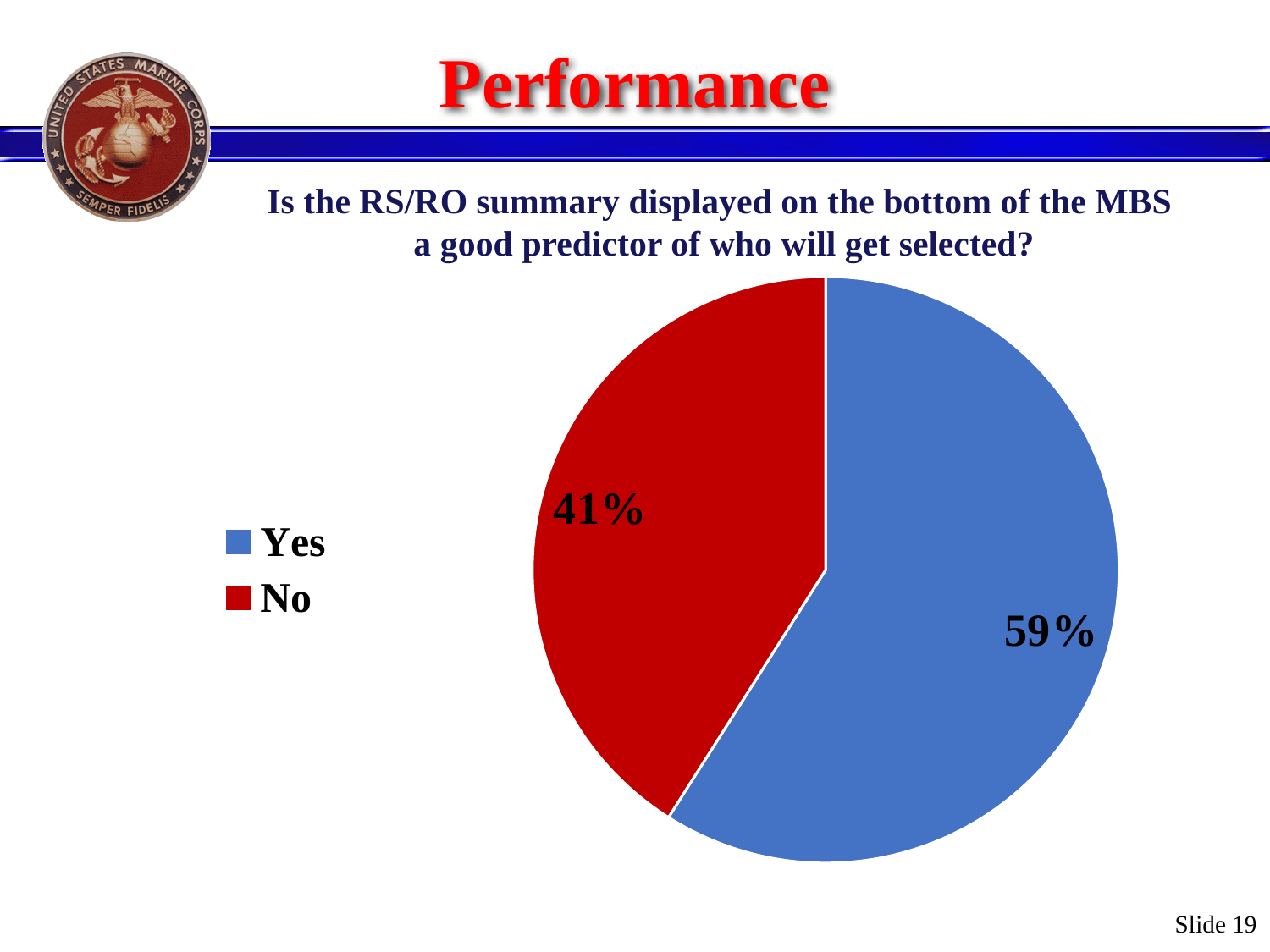
What share of the pie does the No slice represent? 41% What percentage of respondents answered No? 41% Which response has the smallest share of the pie? No Which is larger, the share for Yes or the share for No? Yes What percentage of respondents answered Yes? 59% What colour is the Yes slice? blue Which response has the largest share of the pie? Yes What question does the pie chart summarise responses to? Is the RS/RO summary displayed on the bottom of the MBS a good predictor of who will get selected? How many slices does the pie chart have? 2 How many entries does the legend list? 2 What is the difference in percentage points between the Yes and No shares? 18 What kind of chart is shown on the slide? pie chart